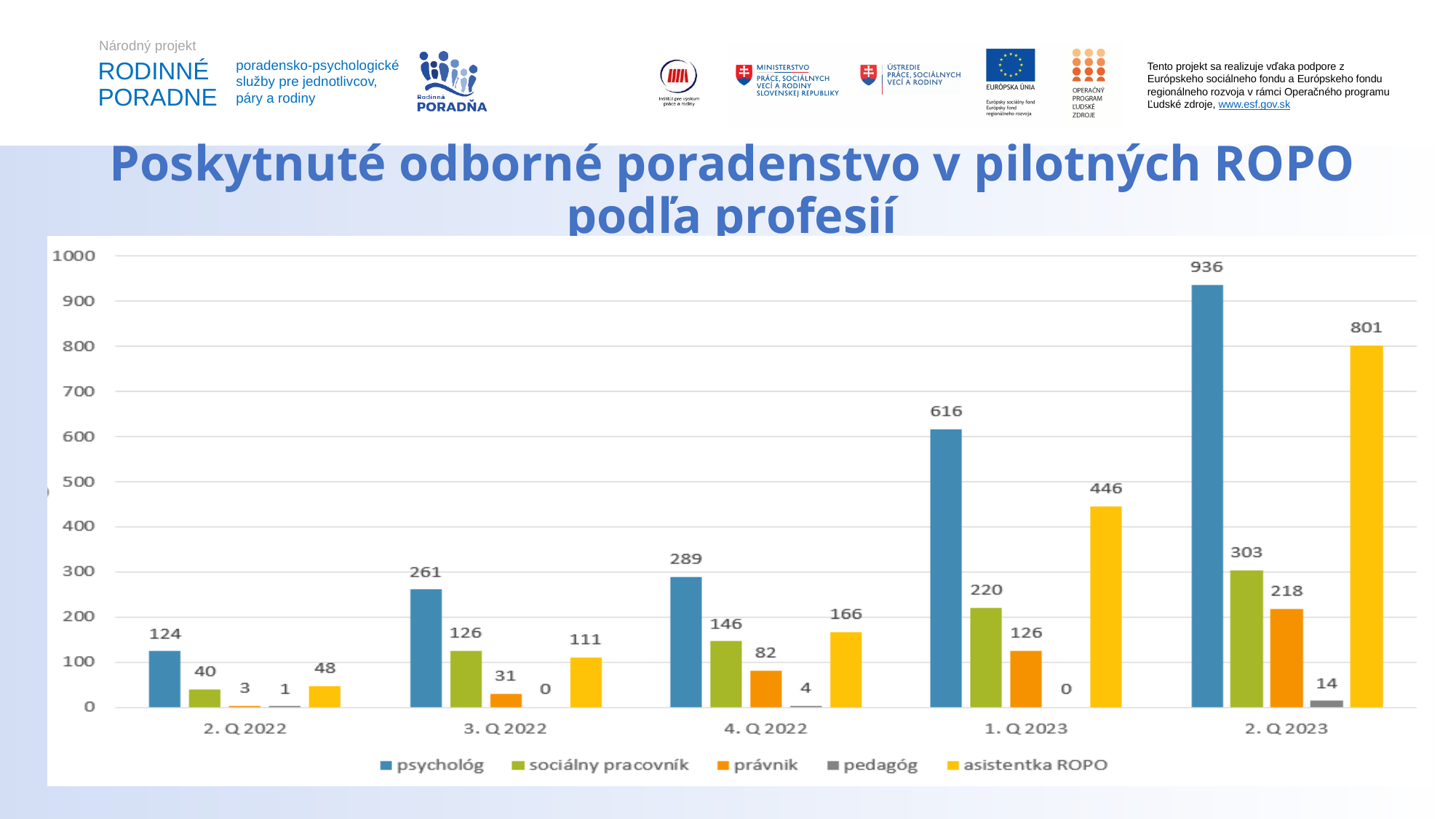
What is the value for psychológ in 2. Q 2023? 936 How many quarters are shown on the x axis? 5 In which quarter is the value for sociálny pracovník lowest? 2. Q 2022 What is the value for pedagóg in 3. Q 2022? 0 In which quarter is the value for psychológ highest? 2. Q 2023 How many series does the legend list? 5 What is the value for asistentka ROPO in 1. Q 2023? 446 What is the value for právnik in 4. Q 2022? 82 Does the value for psychológ rise or fall from 2. Q 2022 to 2. Q 2023? rise What is the difference between the psychológ and asistentka ROPO values in 2. Q 2023? 135 Which is larger in 1. Q 2023: sociálny pracovník or právnik? sociálny pracovník What kind of chart is shown on the slide? bar chart